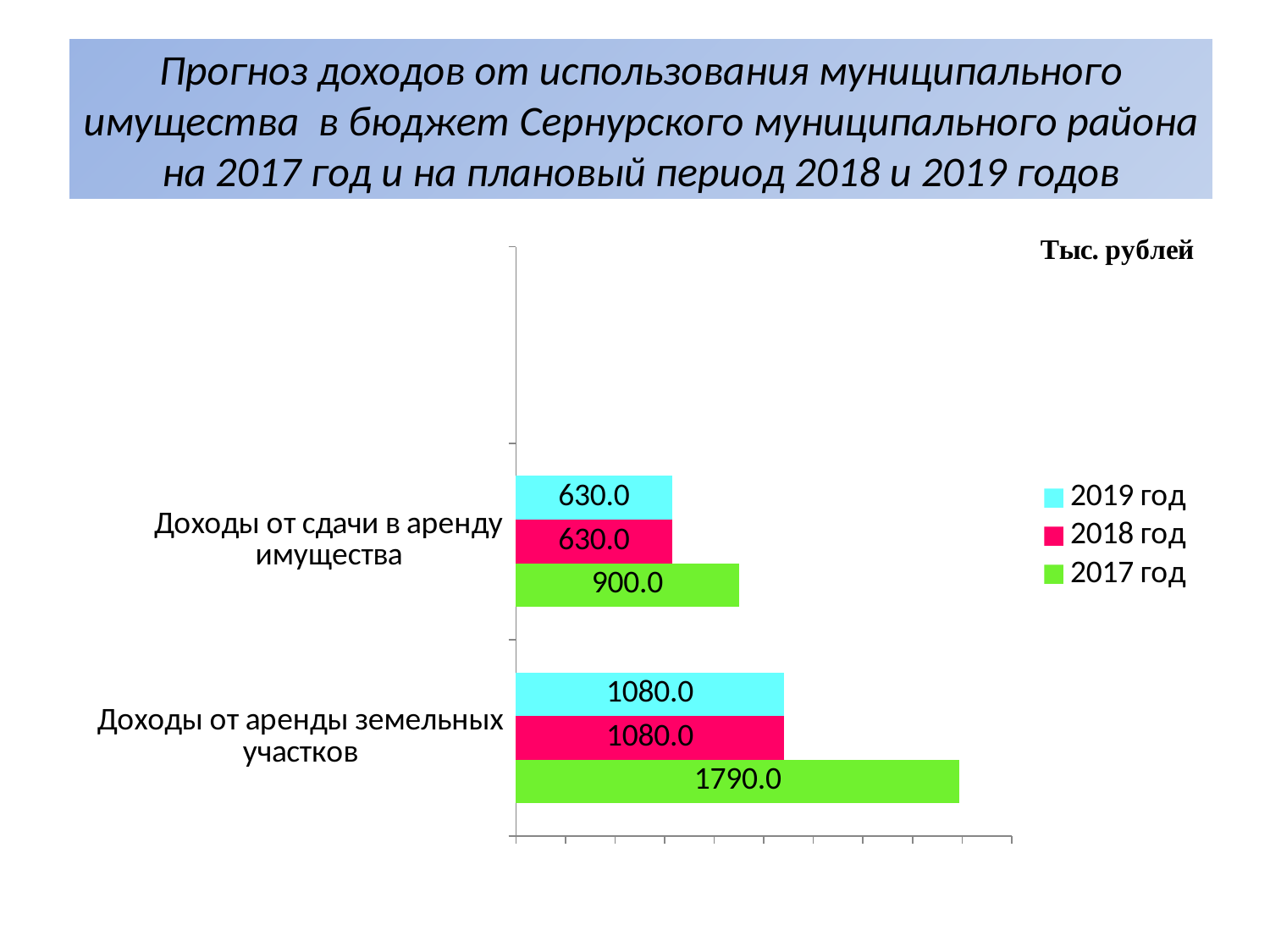
What is the difference between the 2017 год and 2018 год values for Доходы от аренды земельных участков? 710.0 Which category has the lowest value for 2019 год? Доходы от сдачи в аренду имущества Which is larger: the 2017 год value for Доходы от сдачи в аренду имущества or the 2019 год value for Доходы от аренды земельных участков? 2019 год value for Доходы от аренды земельных участков What is the value for 2017 год for Доходы от сдачи в аренду имущества? 900.0 What is the value for 2017 год for Доходы от аренды земельных участков? 1790.0 What is the value for 2018 год for Доходы от аренды земельных участков? 1080.0 What kind of chart is shown on the slide? Bar chart How many series does the legend list? 3 Which category has the highest value for 2017 год? Доходы от аренды земельных участков What is the difference between the 2017 год and 2019 год values for Доходы от сдачи в аренду имущества? 270.0 What is the value for 2019 год for Доходы от сдачи в аренду имущества? 630.0 What unit is indicated in the top right corner of the chart? Тыс. рублей